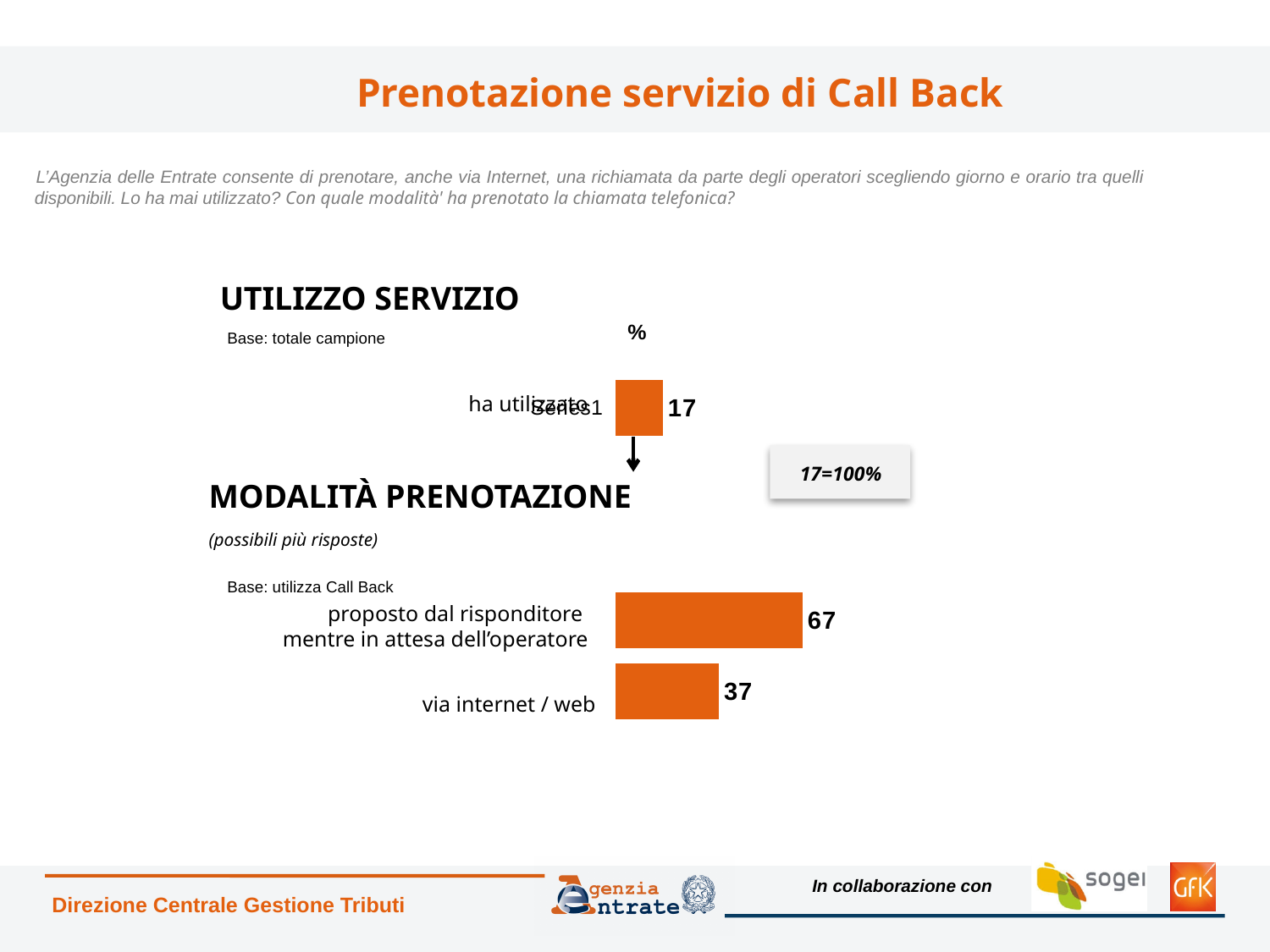
How many bars are shown in the UTILIZZO SERVIZIO chart? 1 What kind of chart is the MODALITÀ PRENOTAZIONE chart? bar chart In the MODALITÀ PRENOTAZIONE chart, what is the value for "via internet / web"? 37 What colour are the bars in the MODALITÀ PRENOTAZIONE chart? orange How many bars are shown in the MODALITÀ PRENOTAZIONE chart? 2 In the MODALITÀ PRENOTAZIONE chart, which category has the highest value? proposto dal risponditore mentre in attesa dell'operatore In the MODALITÀ PRENOTAZIONE chart, which is larger: the value for "via internet / web" or the value for "proposto dal risponditore mentre in attesa dell'operatore"? proposto dal risponditore mentre in attesa dell'operatore In the MODALITÀ PRENOTAZIONE chart, what is the value for "proposto dal risponditore mentre in attesa dell'operatore"? 67 In the UTILIZZO SERVIZIO chart, what is the value for "ha utilizzato"? 17 In the MODALITÀ PRENOTAZIONE chart, which category has the lowest value? via internet / web In the MODALITÀ PRENOTAZIONE chart, what is the difference between the value for "proposto dal risponditore mentre in attesa dell'operatore" and the value for "via internet / web"? 30 What is the difference between the value for "via internet / web" in the MODALITÀ PRENOTAZIONE chart and the value for "ha utilizzato" in the UTILIZZO SERVIZIO chart? 20